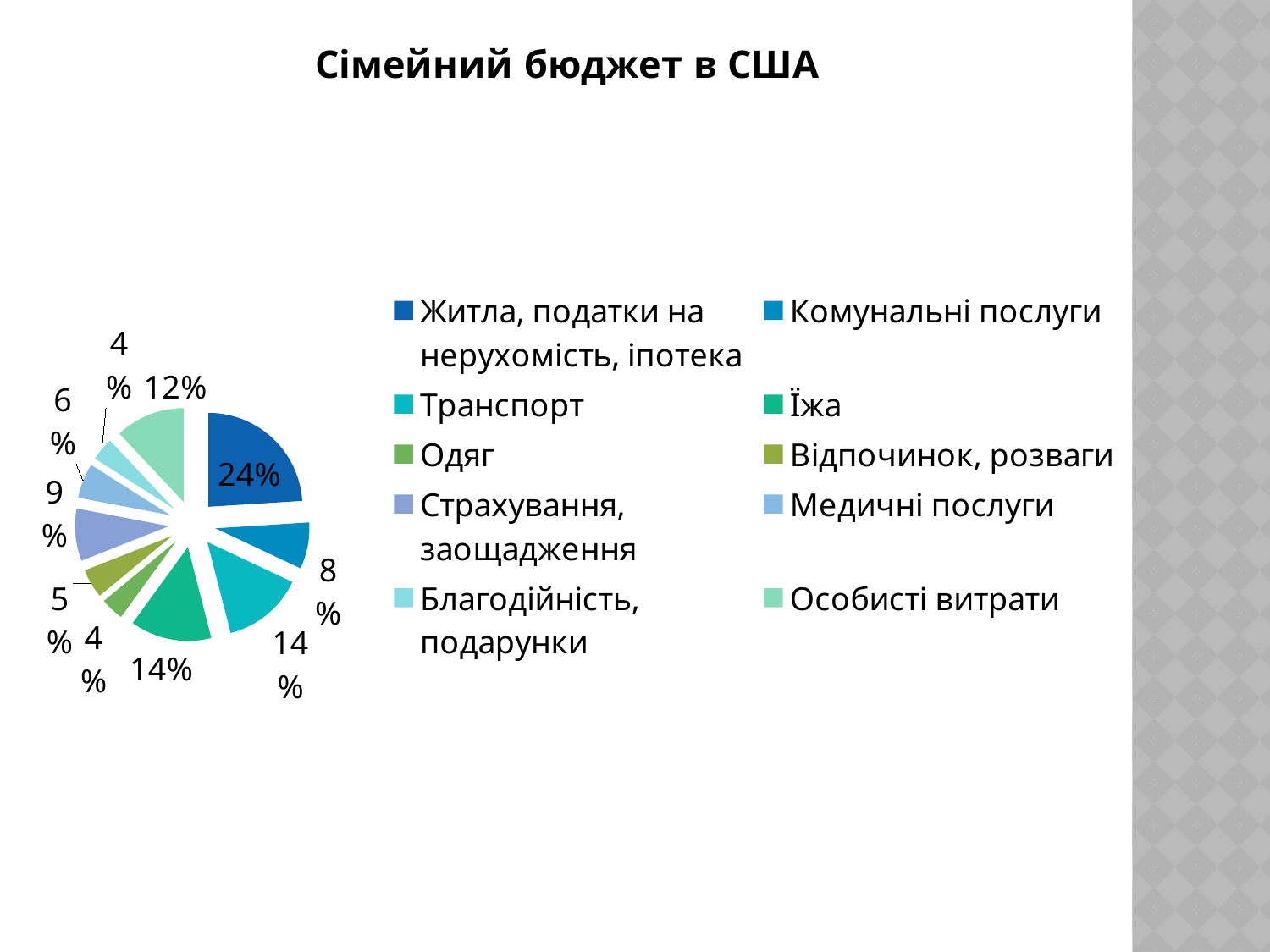
What is the difference between the share for Житла, податки на нерухомість, іпотека and the share for Особисті витрати? 12% What is the title of the chart? Сімейний бюджет в США What share of the budget goes to Житла, податки на нерухомість, іпотека? 24% What share of the budget goes to Медичні послуги? 6% Which category has the largest share of the budget? Житла, податки на нерухомість, іпотека What kind of chart is shown on the slide? pie chart How many categories does the legend list? 10 What is the difference between the share for Транспорт and the share for Комунальні послуги? 6% What share of the budget goes to Особисті витрати? 12% Which is larger, the share for Страхування, заощадження or the share for Відпочинок, розваги? Страхування, заощадження